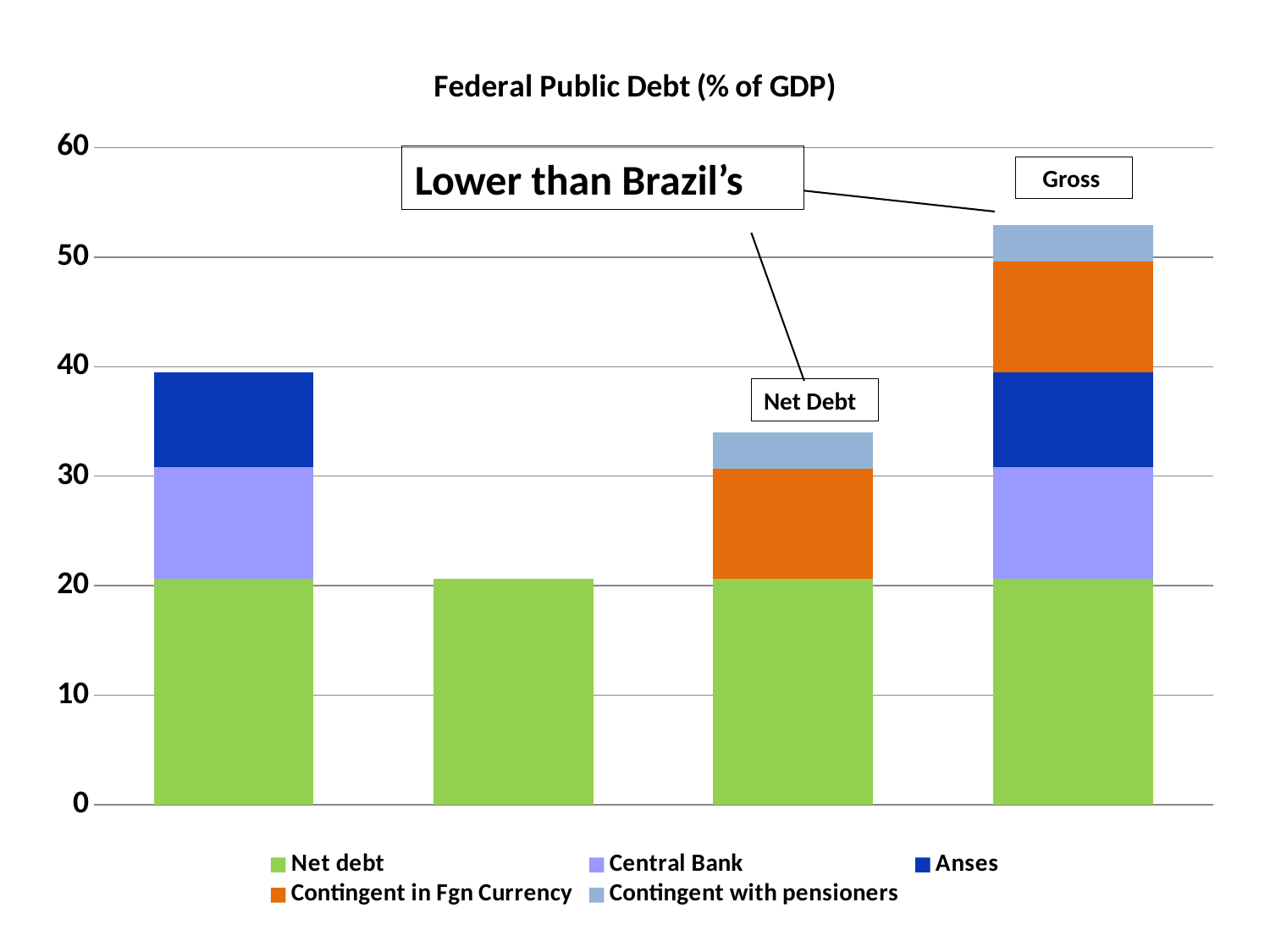
Is the total of the rightmost bar greater or less than 50? greater Is the value of the second bar greater or less than 30? less Is the total of the first (leftmost) bar greater or less than 30? greater What kind of chart is shown on the slide? bar chart How many series does the legend list? 5 Which series is shown in green in the legend? Net debt What is the title of the chart? Federal Public Debt (% of GDP) Which has a larger total, the first bar or the third bar? the first bar Which bar has the lowest total value? the second bar Which bar has the highest total value? the fourth (rightmost) bar How many bars are plotted in the chart? 4